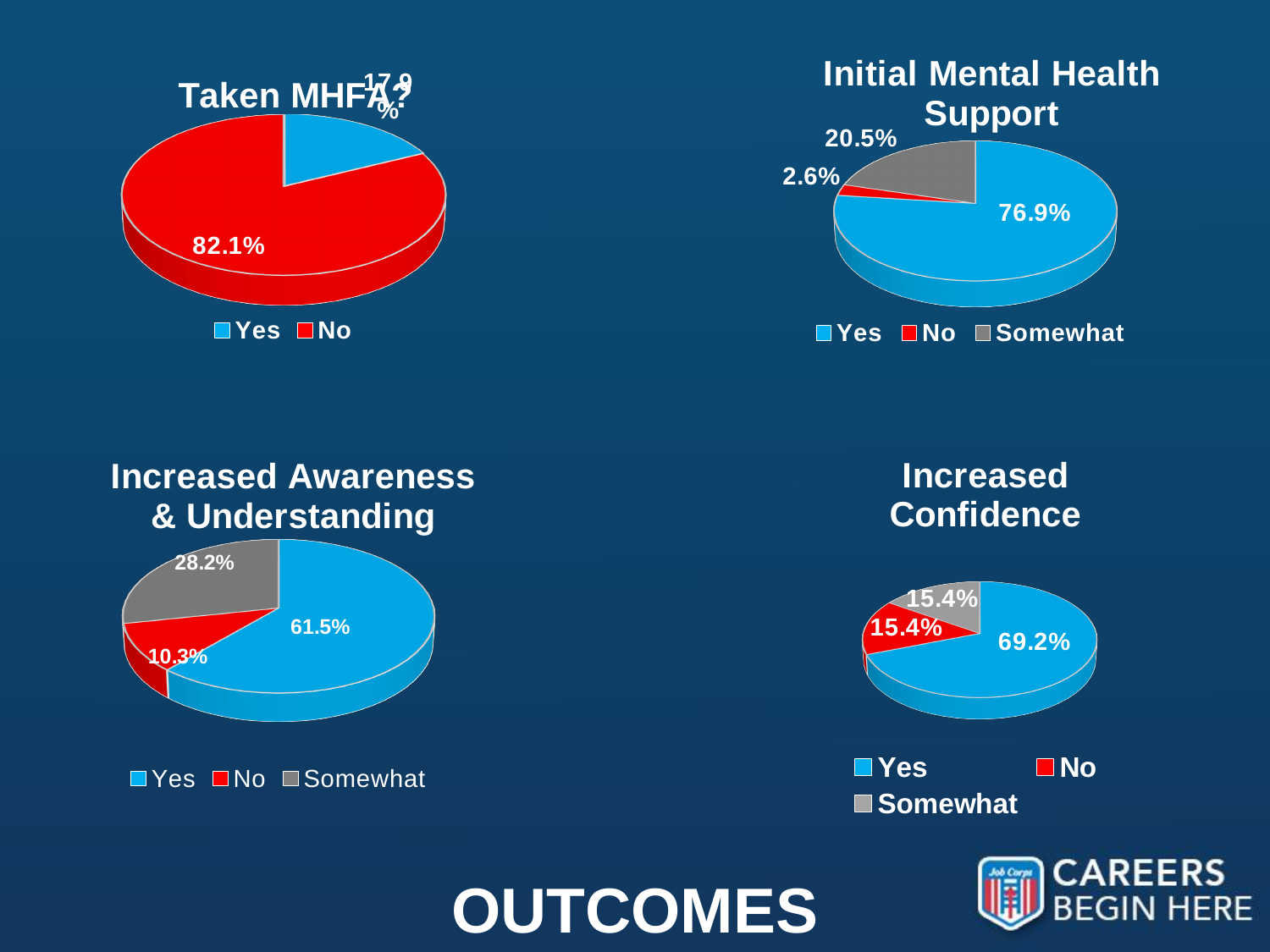
In the 'Increased Awareness & Understanding' chart, what is the difference between the Yes and Somewhat shares? 33.3% How many slices does the 'Initial Mental Health Support' chart have? 3 In the 'Increased Confidence' chart, what percentage answered Yes? 69.2% In the 'Taken MHFA?' chart, what percentage answered No? 82.1% In the 'Initial Mental Health Support' chart, what percentage answered Somewhat? 20.5% What type of chart is the 'Increased Confidence' chart? Pie chart In the 'Initial Mental Health Support' chart, which response has the smallest share? No In the 'Increased Confidence' chart, is the share for No larger or smaller than the share for Yes? smaller How many entries does the legend of the 'Taken MHFA?' chart list? 2 In the 'Increased Awareness & Understanding' chart, which response has the largest share? Yes In the 'Initial Mental Health Support' chart, what percentage answered Yes? 76.9% In the 'Increased Awareness & Understanding' chart, what percentage answered No? 10.3%